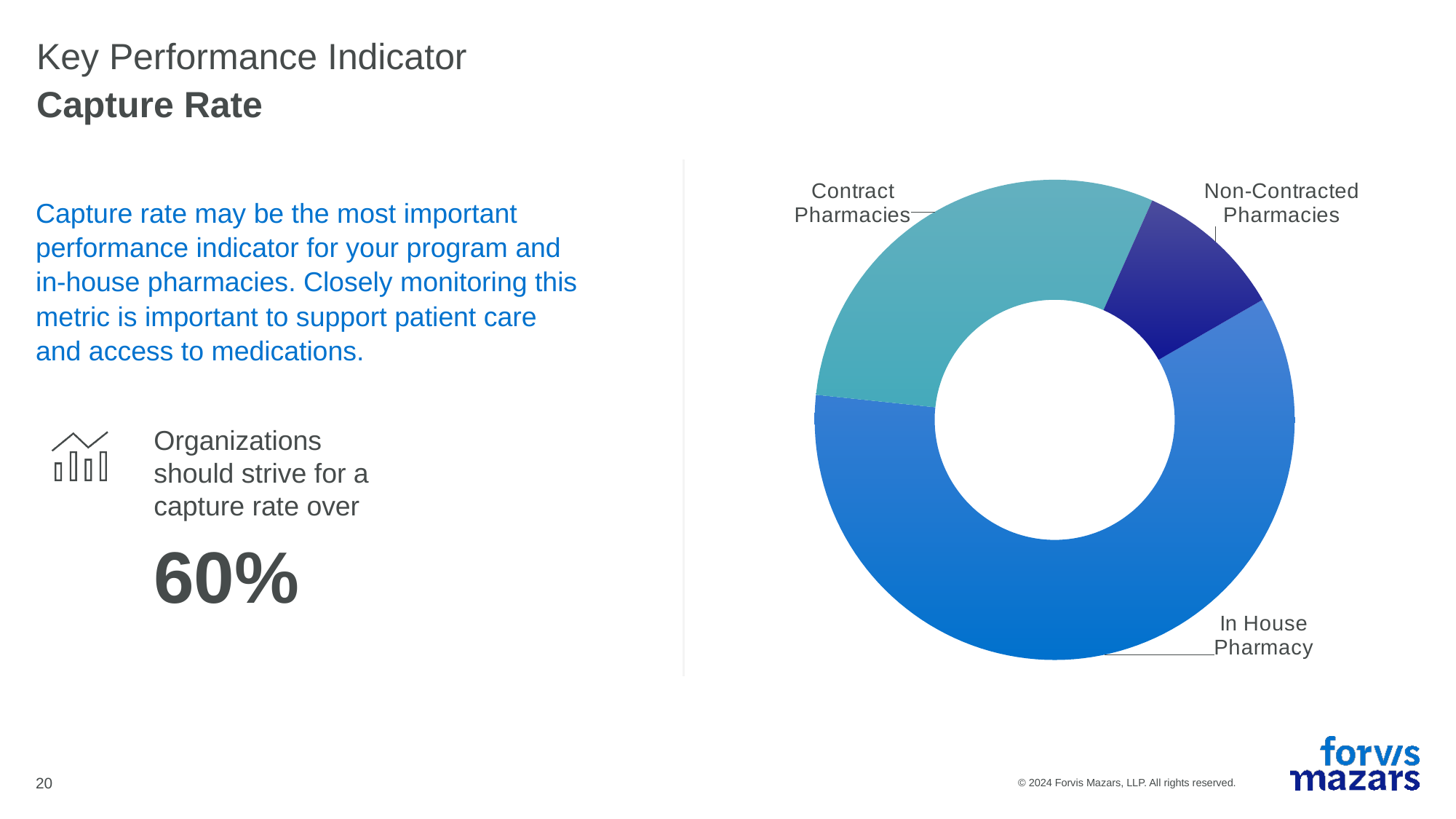
Which slice is smaller: In House Pharmacy or Non-Contracted Pharmacies? Non-Contracted Pharmacies Which category has the smallest slice in the donut chart? Non-Contracted Pharmacies Which slice is larger: In House Pharmacy or Contract Pharmacies? In House Pharmacy What colour is the Contract Pharmacies slice in the donut chart? Teal What kind of chart is shown on the slide? Donut (pie) chart How many categories (slices) does the donut chart have? 3 Which slice is larger: Contract Pharmacies or Non-Contracted Pharmacies? Contract Pharmacies Which category has the largest slice in the donut chart? In House Pharmacy What colour is the In House Pharmacy slice in the donut chart? Blue